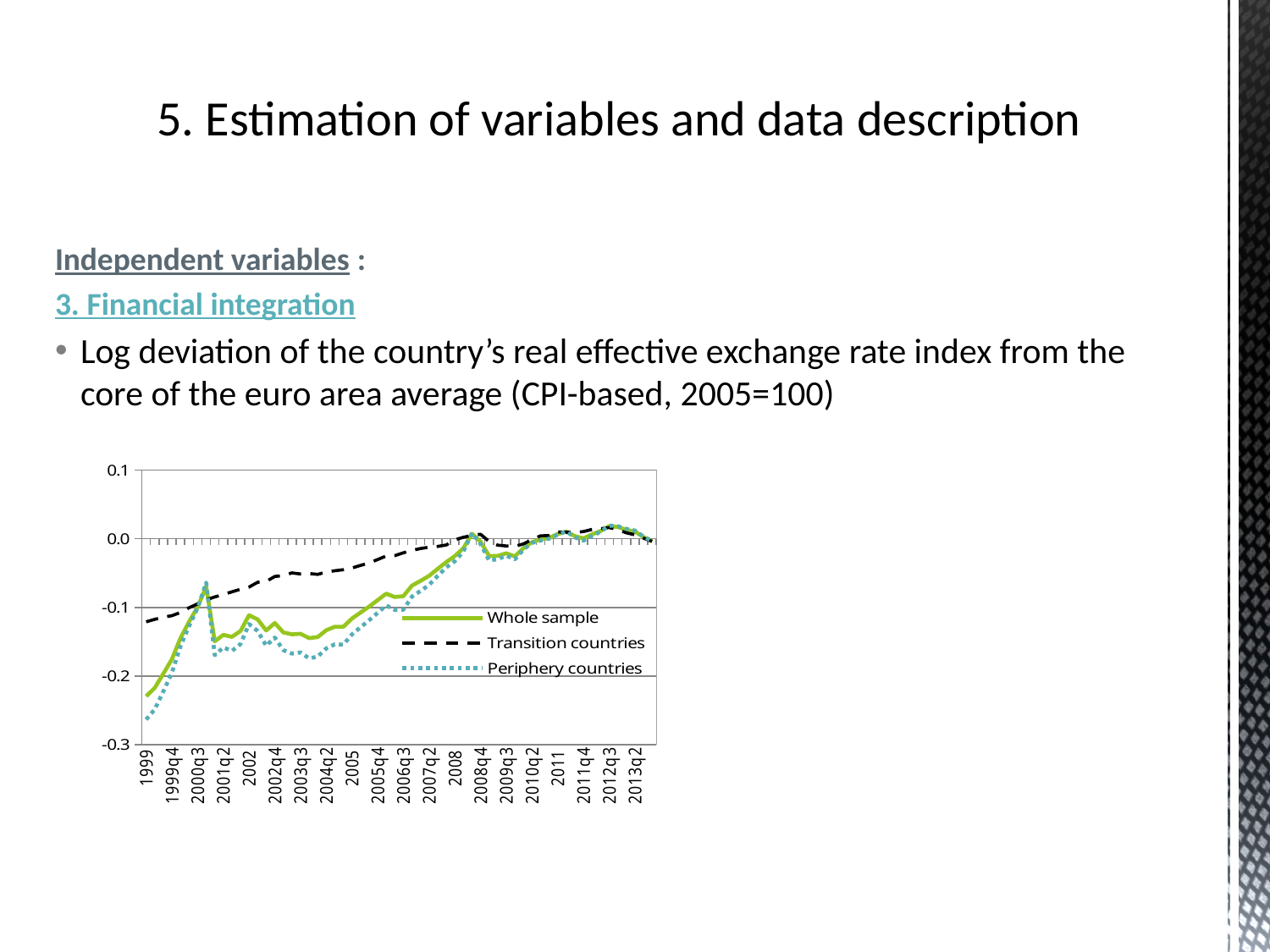
What kind of chart is shown on the slide? line chart In 2003q3, which series has the higher value, Whole sample or Periphery countries? Whole sample How many series does the chart's legend list? 3 Which series is drawn as a dashed black line? Transition countries Which series has the lowest value in 1999? Periphery countries In 1999, which series has the higher value, Transition countries or Periphery countries? Transition countries Is the value for Periphery countries in 1999 greater or less than -0.2? less Is the value for Transition countries in 1999 greater or less than -0.1? less Is the value for Periphery countries in 2003q3 greater or less than -0.1? less Which series are listed in the chart's legend? Whole sample, Transition countries, Periphery countries Do the values for Whole sample generally rise or fall from 1999 to 2008? rise